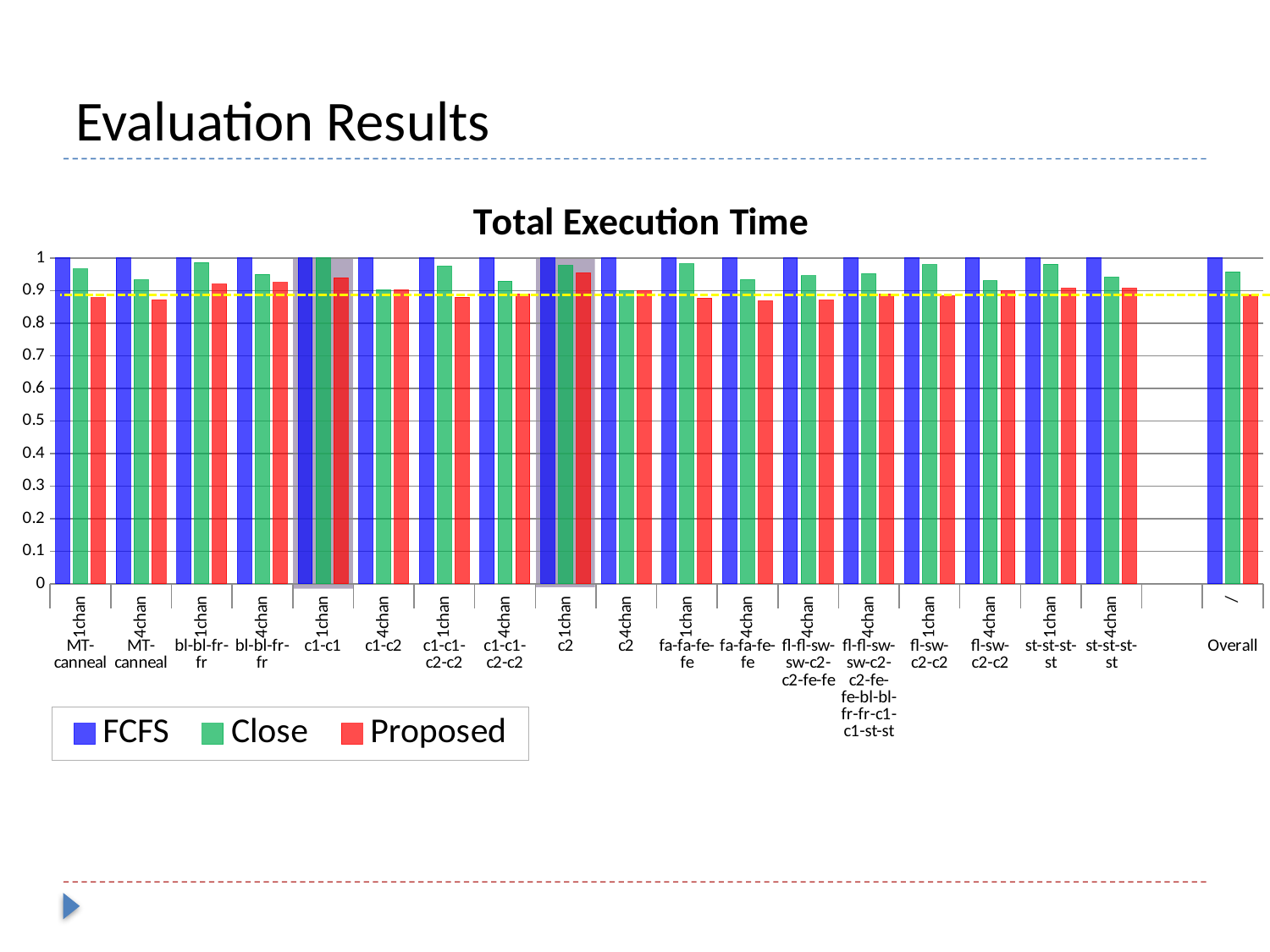
Is the Close value for bl-bl-fr-fr 1chan greater or less than 0.9? greater Which series are listed in the legend? FCFS, Close, Proposed For Overall, which is larger: the FCFS value or the Proposed value? FCFS Is the Close value for MT-canneal 1chan greater or less than 0.9? greater What kind of chart is shown on the slide? bar chart For MT-canneal 1chan, which is larger: the Close value or the Proposed value? Close Which category has the highest Close value? c1-c1 1chan What is the FCFS value for Overall? 1 What is the title of the chart? Total Execution Time How many series does the legend list? 3 What is the FCFS value for MT-canneal 1chan? 1 Is the Proposed value for fa-fa-fe-fe 4chan greater or less than 0.9? less